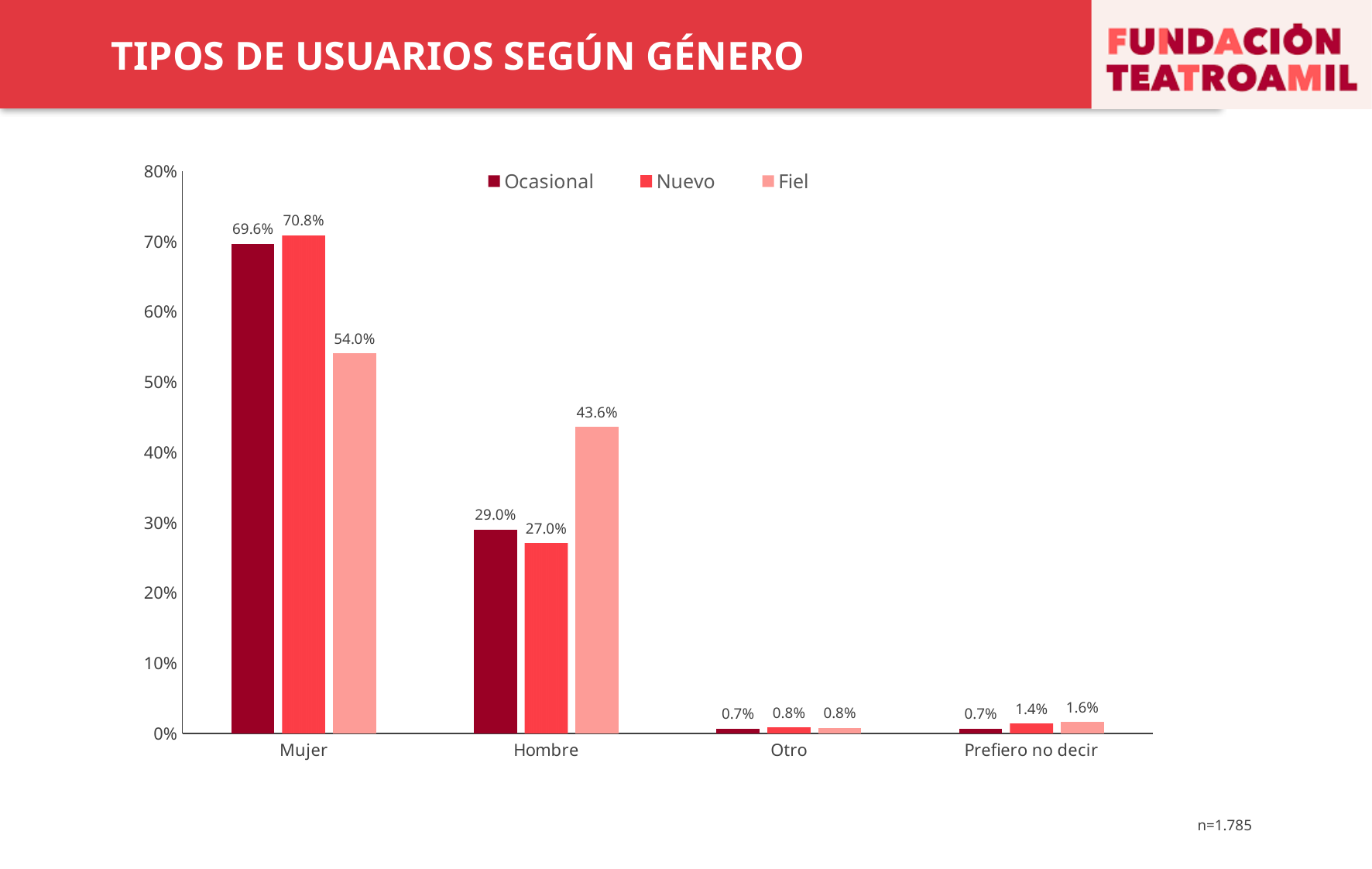
What is the value for Ocasional in the Mujer category? 69.6% What kind of chart is shown on the slide? bar chart Which category has the highest value for the Fiel series? Mujer How many categories are shown on the x axis? 4 How many series does the legend list? 3 What is the value for Nuevo in the Prefiero no decir category? 1.4% What is the value for Fiel in the Hombre category? 43.6% In the Hombre category, which is larger: Ocasional or Fiel? Fiel What is the difference between the Ocasional and Nuevo values in the Hombre category? 2.0% Is the value for Fiel in the Mujer category greater or less than 50%? greater Which category has the lowest value for the Nuevo series? Otro What is the difference between the Nuevo and Fiel values in the Mujer category? 16.8%